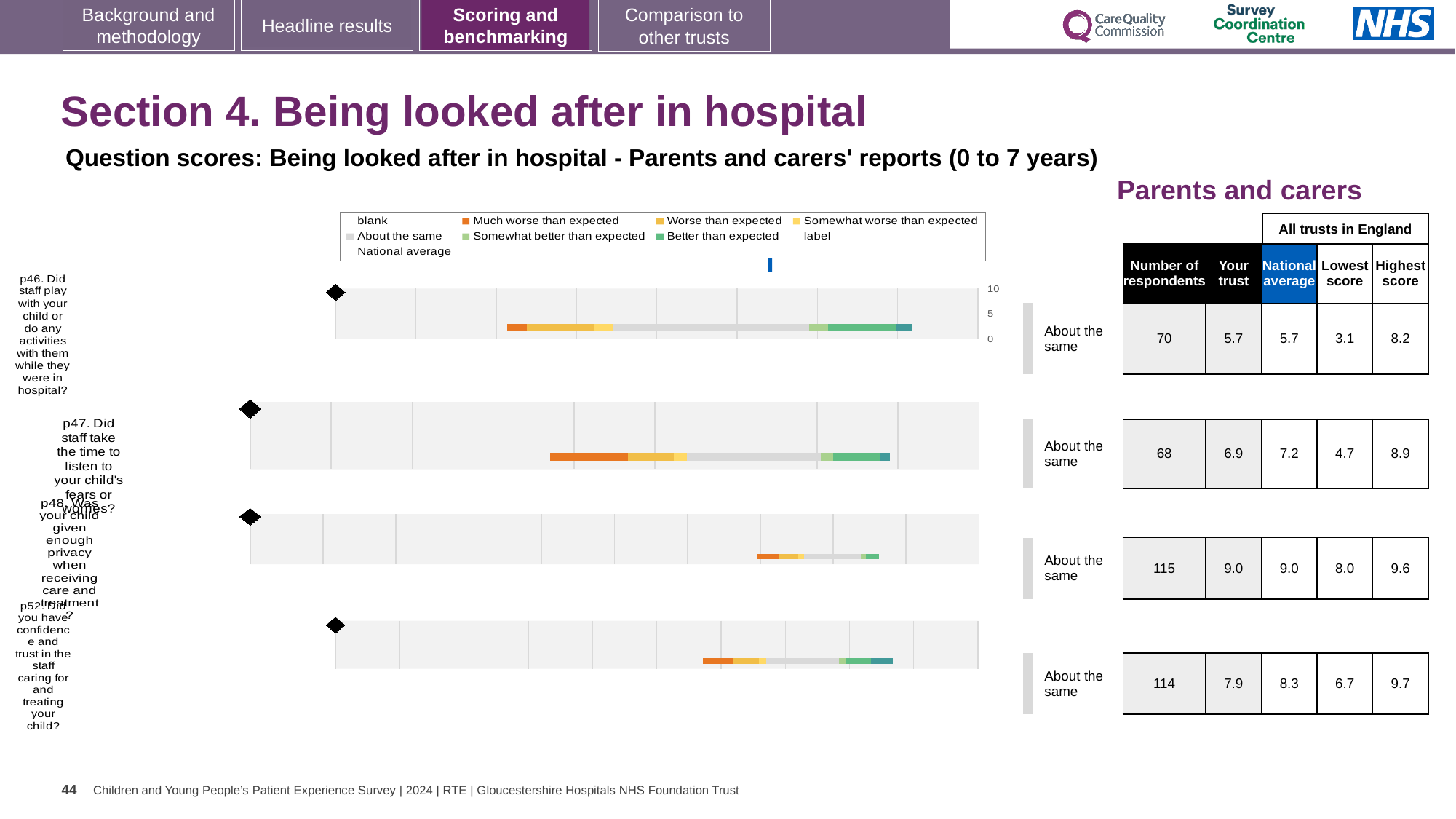
What kind of chart is used to show the question scores on this slide? bar chart For p46 (Did staff play with your child or do any activities with them while they were in hospital?), what is the 'Your trust' score? 5.7 What is the lowest score across all trusts in England for p46? 3.1 For p47, which is larger: the 'Your trust' score or the national average? National average For p52, what is the difference between the highest score and the lowest score? 3.0 What is the highest score across all trusts in England for p52 (Did you have confidence and trust in the staff caring for and treating your child?)? 9.7 How many question charts are shown on the slide? 4 For p47 (Did staff take the time to listen to your child's fears or worries?), what is the national average score? 7.2 What benchmark category is shown next to the chart for p46? About the same What colour represents 'Much worse than expected' in the legend? orange Which question has the highest 'Your trust' score? p48 How many respondents are there for p48 (Was your child given enough privacy when receiving care and treatment?)? 115